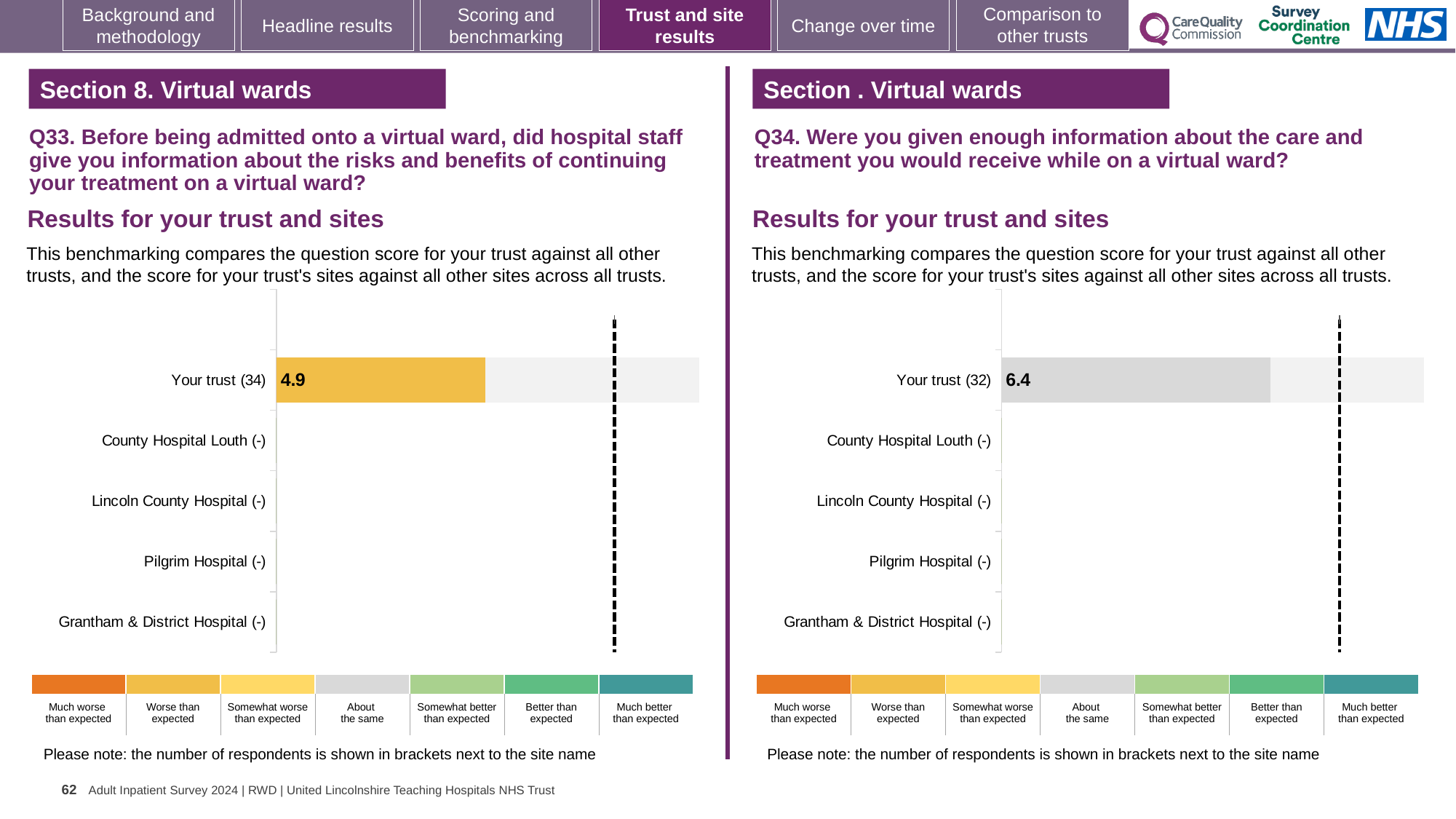
How many respondents are shown in brackets for Your trust in the Q33 chart on the left? 34 What type of chart is used for the Q33 results on the left? Bar chart In the Q33 chart on the left, which benchmark category does the colour of the Your trust bar correspond to in the legend? Worse than expected How many respondents are shown in brackets for Your trust in the Q34 chart on the right? 32 Which is larger: the Your trust score in the Q33 chart on the left or the Your trust score in the Q34 chart on the right? Q34 (6.4) In the Q33 chart on the left, what is the score for Your trust? 4.9 In the Q34 chart on the right, what is the score for Your trust? 6.4 How many categories (rows) are listed on the y axis of the Q34 chart on the right? 5 In the Q34 chart on the right, which benchmark category does the colour of the Your trust bar correspond to in the legend? About the same In the Q33 chart on the left, which category is listed last on the y axis? Grantham & District Hospital (-) How many categories (rows) are listed on the y axis of the Q33 chart on the left? 5 What is the difference between the Your trust score in the Q34 chart on the right and the Your trust score in the Q33 chart on the left? 1.5